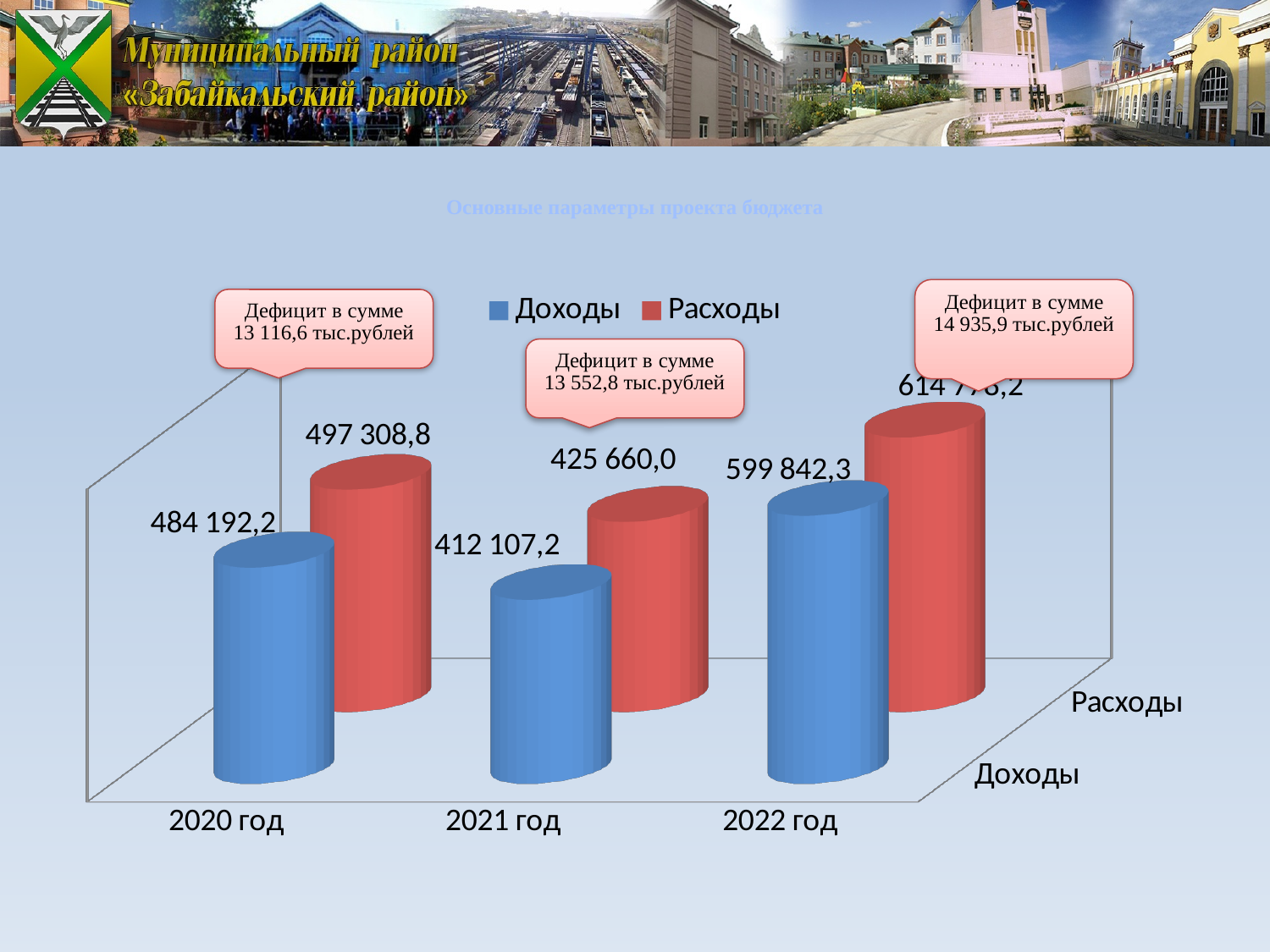
What is the difference between Расходы and Доходы in 2020 год? 13 116,6 What is the value for Доходы in 2021 год? 412 107,2 In which year is Доходы the highest? 2022 год What kind of chart is shown on the slide? bar chart What is the value for Расходы in 2020 год? 497 308,8 What is the value for Доходы in 2022 год? 599 842,3 In which year is Доходы the lowest? 2021 год In 2021 год, which is larger: Доходы or Расходы? Расходы What is the value for Доходы in 2020 год? 484 192,2 What is the value for Расходы in 2021 год? 425 660,0 How many years are shown on the x axis? 3 How many series does the legend list? 2